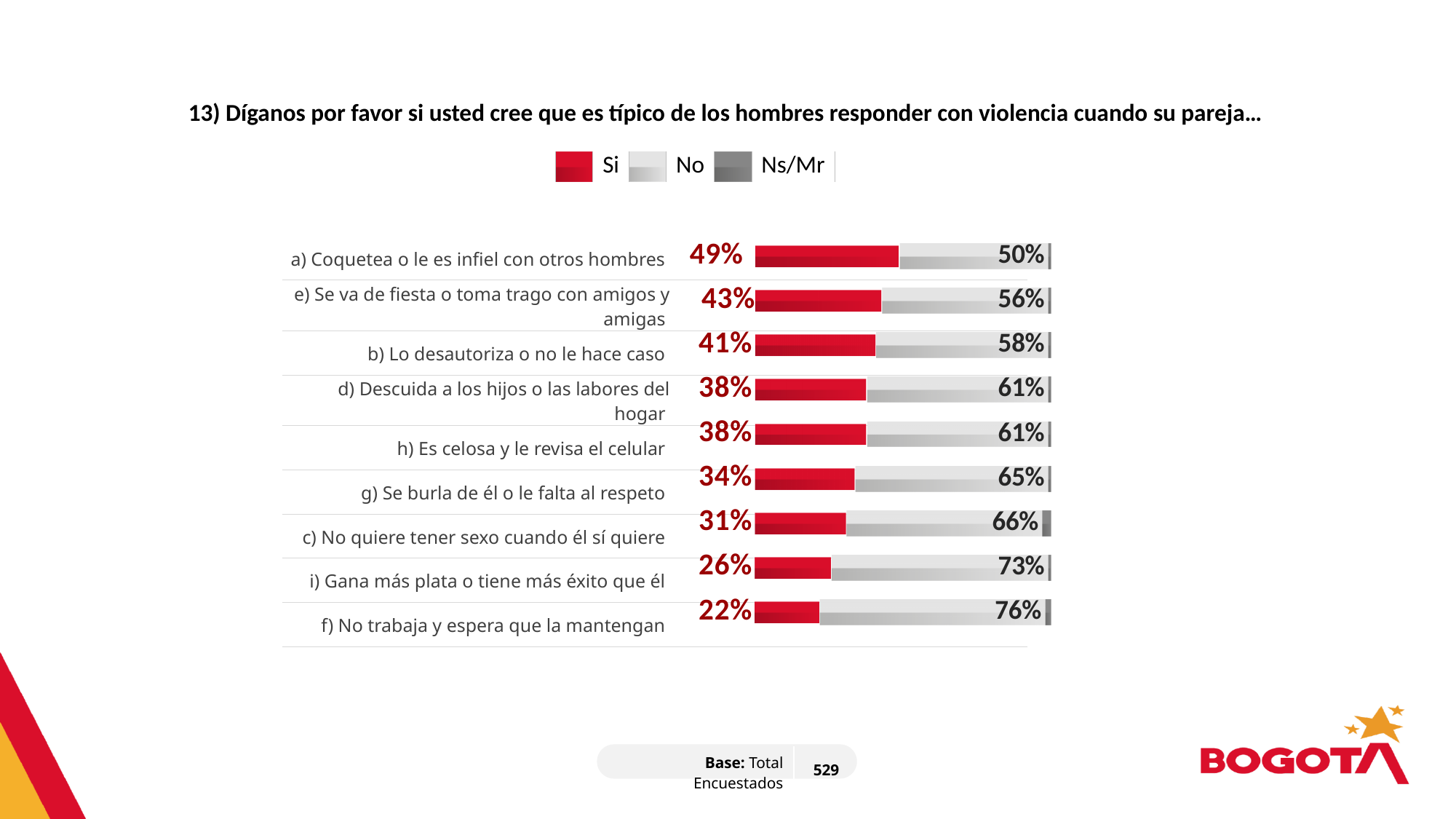
How many categories (statements) are shown in the chart? 9 Which category has the lowest "Si" percentage? f) No trabaja y espera que la mantengan What percentage answered "Si" for "a) Coquetea o le es infiel con otros hombres"? 49% What is the "Si" value for "c) No quiere tener sexo cuando él sí quiere"? 31% Which has a larger "No" percentage: "b) Lo desautoriza o no le hace caso" or "g) Se burla de él o le falta al respeto"? g) Se burla de él o le falta al respeto What is the difference between the "Si" values for "e) Se va de fiesta o toma trago con amigos y amigas" and "i) Gana más plata o tiene más éxito que él"? 17% What kind of chart is shown on the slide? Stacked bar chart Which series is shown in red in the legend? Si How many series does the legend list? 3 What is the "No" value for "h) Es celosa y le revisa el celular"? 61% What percentage answered "No" for "f) No trabaja y espera que la mantengan"? 76% Which category has the highest "Si" percentage? a) Coquetea o le es infiel con otros hombres